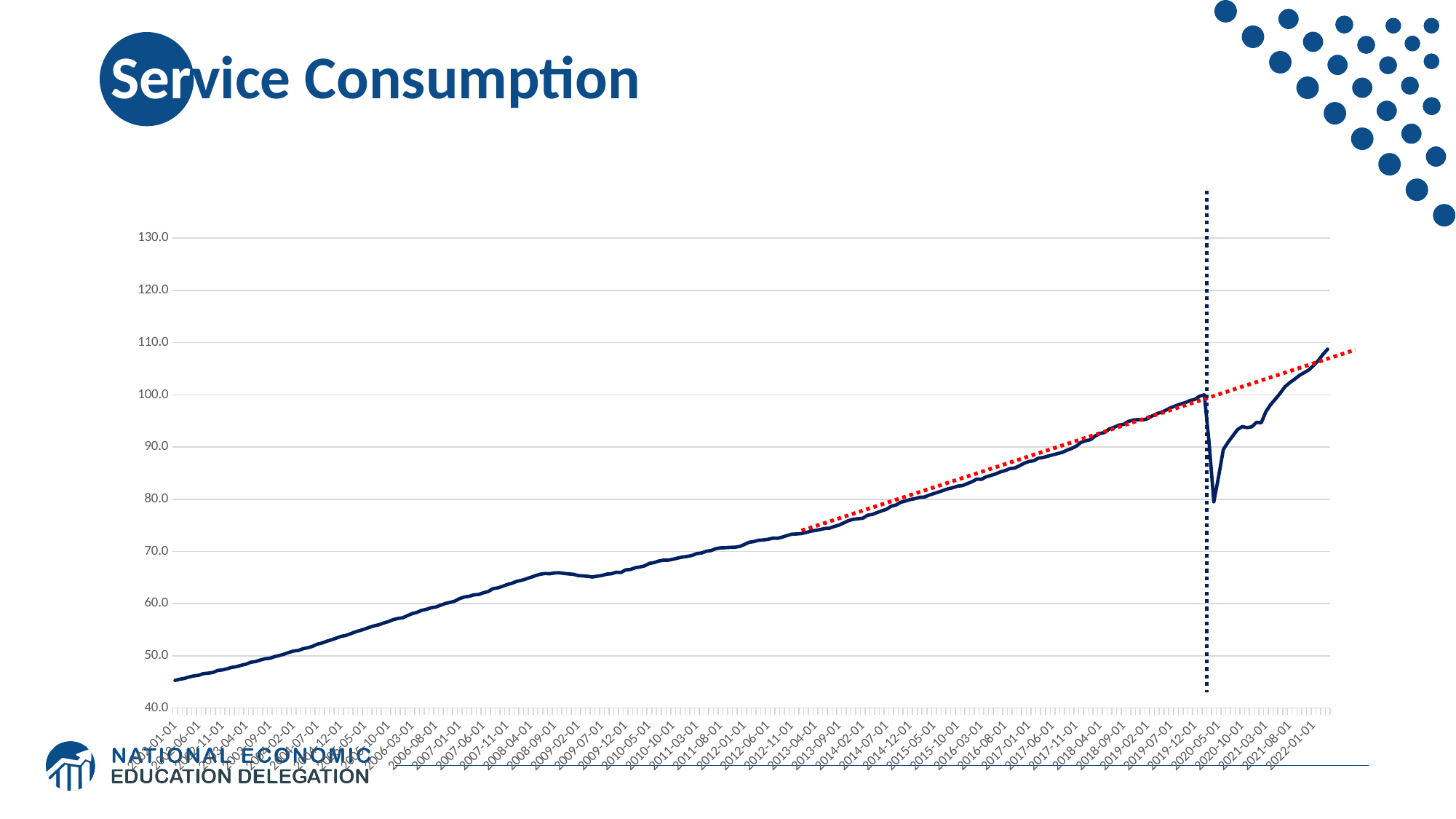
Is the lowest point of the sharp dip in 2020 greater or less than 90? less Is the value of the dark blue line at 2013-04-01 greater or less than 70? greater Is the value of the dark blue line at 2017-01-01 greater or less than 90? less What is the highest value shown on the y axis? 130.0 Is the value of the dark blue line at 2022-01-01 larger or smaller than its value at 2020-05-01? larger Overall, do the values of the dark blue line rise or fall from left to right along the x axis? rise What is the title of the chart? Service Consumption What kind of chart is shown on the slide? line chart